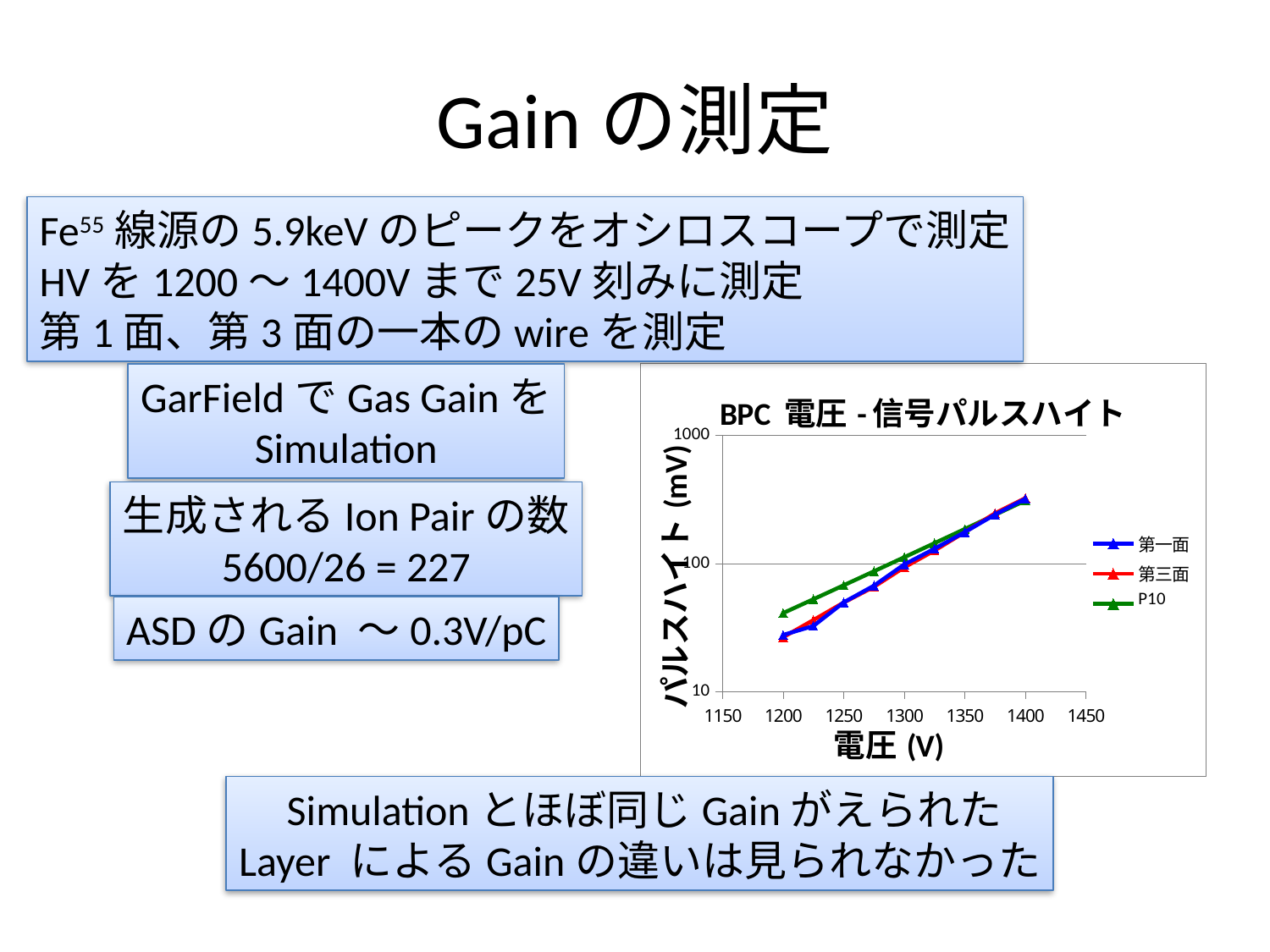
What is the label of the x axis of the chart? 電圧 (V) What is the title of the chart? BPC 電圧 - 信号パルスハイト How many series does the chart legend list? 3 Which series has the highest value at 1250 V? P10 Is the value for P10 at 1200 V greater or less than 100? less At 1200 V, which series has the larger value, P10 or 第一面? P10 Is the value for 第一面 at 1400 V greater or less than 100? greater Do the values for 第一面 rise or fall as the voltage increases along the x axis? rise What kind of chart is shown on the slide? line chart How many data points are plotted for the 第一面 series? 9 Is the value for 第一面 at 1200 V greater or less than 100? less